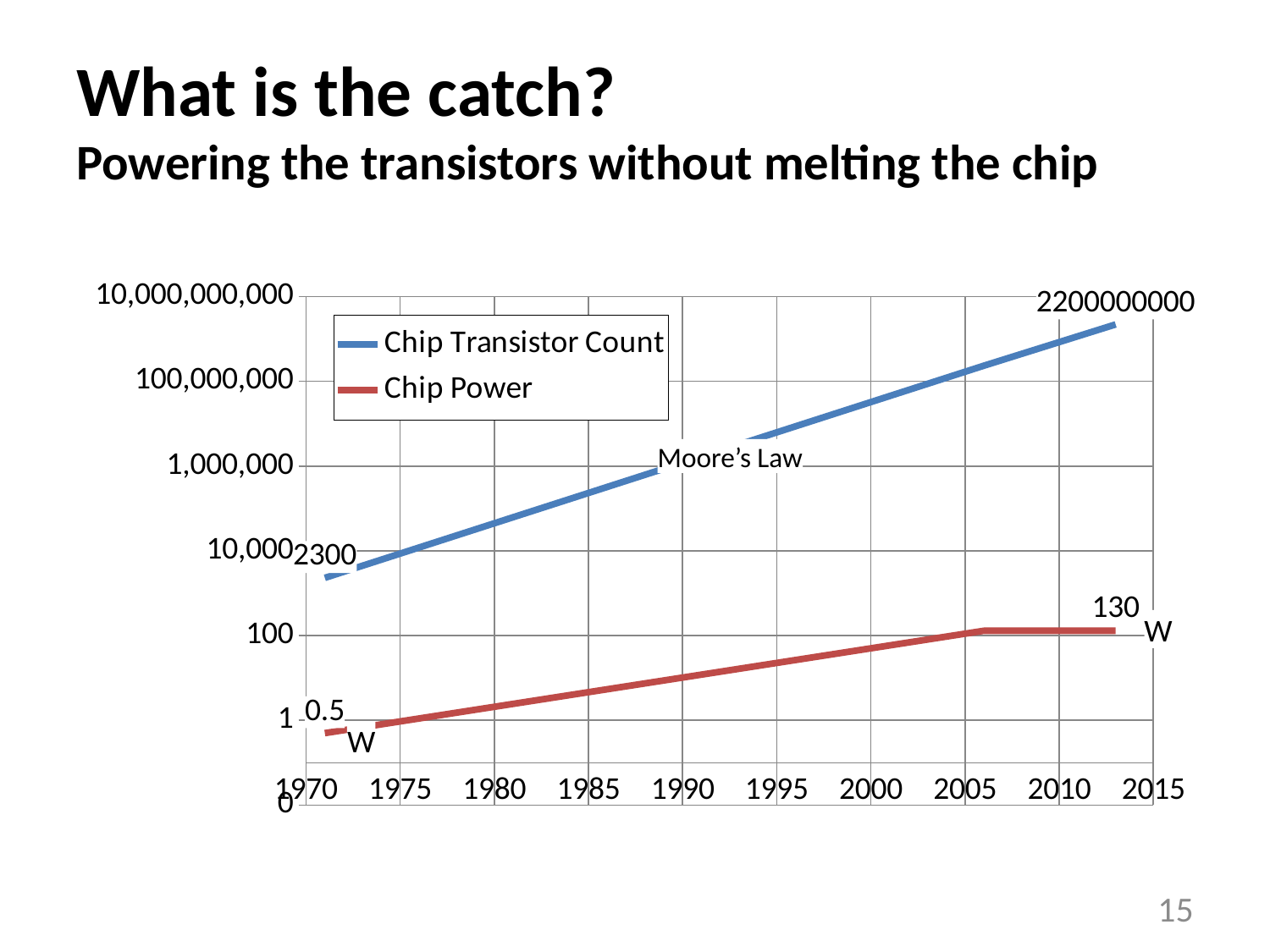
What annotation text is written next to the Chip Transistor Count line? Moore's Law Which series has the higher value around 2010, Chip Transistor Count or Chip Power? Chip Transistor Count How many series does the legend list? 2 What is the data label at the start of the Chip Transistor Count line? 2300 By how much does the Chip Power end label (130) exceed its start label (0.5)? 129.5 Is the Chip Transistor Count value around 2000 greater or less than 1,000,000? greater Does the Chip Transistor Count line rise or fall from 1970 to 2015? Rise What is the data label at the end of the Chip Transistor Count line? 2200000000 Is the Chip Power value around 1990 greater or less than 100? less What is the data label at the end of the Chip Power line? 130 What kind of chart is shown on the slide? Line chart What is the data label at the start of the Chip Power line? 0.5